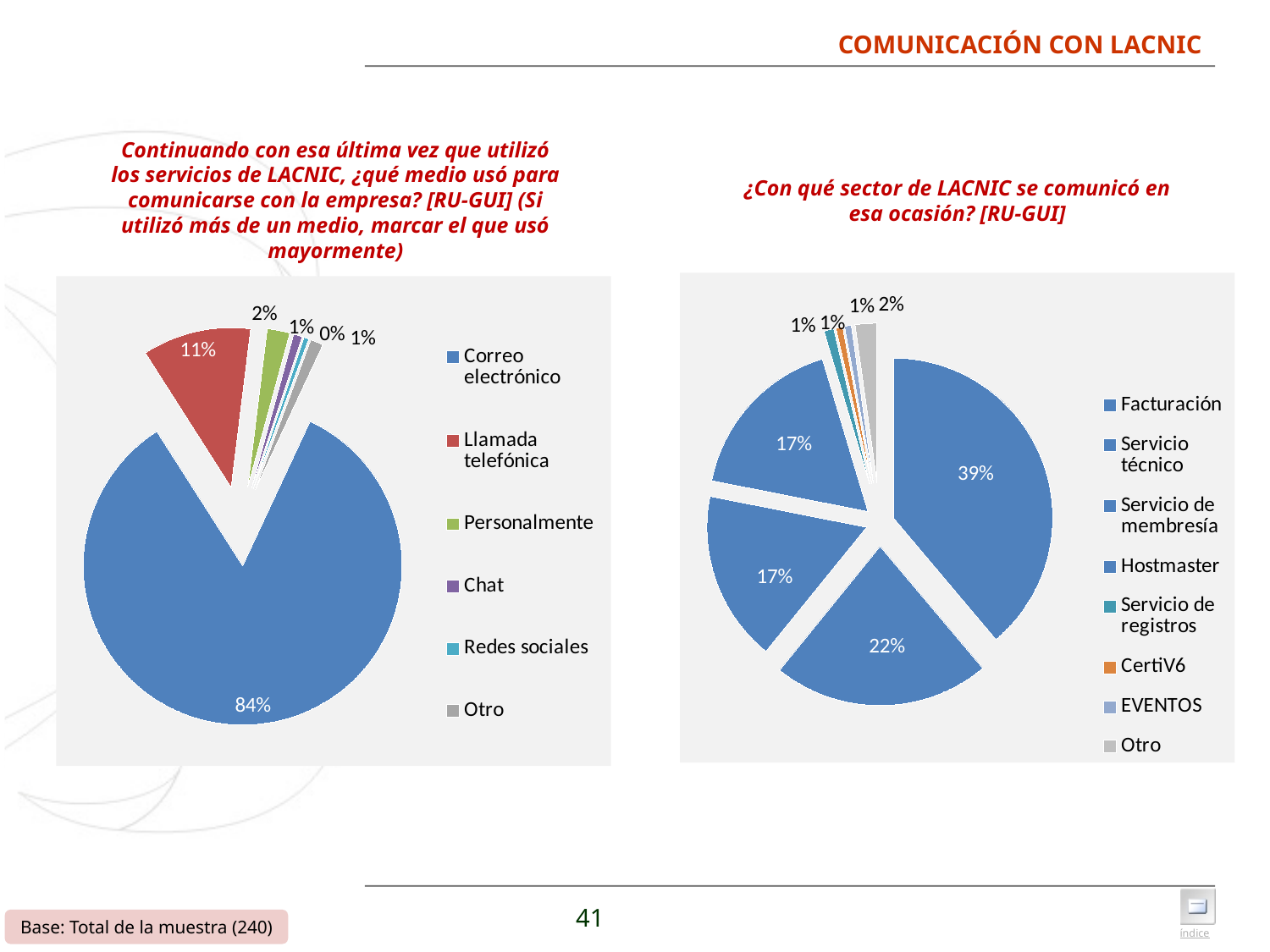
In the left chart (medio usado para comunicarse), how many categories does the legend list? 6 In the left chart (medio usado para comunicarse), which category has the largest share? Correo electrónico What type of chart is used on the left side of the slide? Pie chart In the left chart (medio usado para comunicarse), what percentage corresponds to Llamada telefónica? 11% In the left chart (medio usado para comunicarse), what percentage corresponds to Correo electrónico? 84% In the right chart (sector de LACNIC), which sector has the largest share? Facturación In the right chart (sector de LACNIC), what is the combined share of Servicio de membresía and Hostmaster? 34% In the right chart (sector de LACNIC), what percentage corresponds to Facturación? 39% In the left chart (medio usado para comunicarse), what is the difference in percentage points between Correo electrónico and Llamada telefónica? 73 In the right chart (sector de LACNIC), what percentage corresponds to Servicio técnico? 22% In the right chart (sector de LACNIC), which is larger, Facturación or Servicio técnico? Facturación In the right chart (sector de LACNIC), how many categories does the legend list? 8